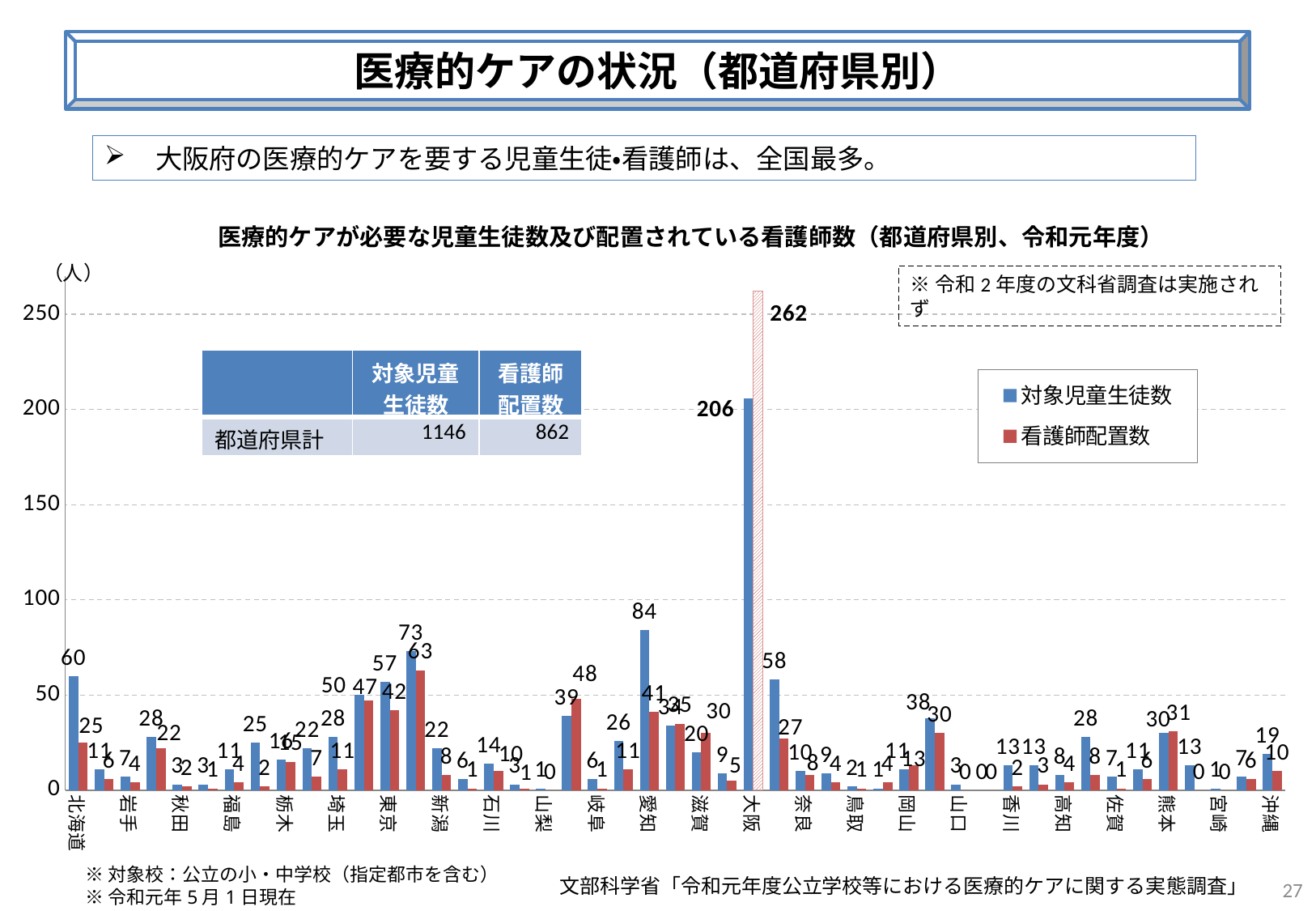
According to the table inside the chart, what is the 都道府県計 value for 対象児童生徒数? 1146 Which prefecture has the highest 対象児童生徒数? 大阪 Which has the larger 対象児童生徒数, 東京 or 愛知? 愛知 What is the difference between the 対象児童生徒数 and 看護師配置数 values for 北海道? 35 What is the 看護師配置数 value for 滋賀? 30 What is the 対象児童生徒数 value for 愛知? 84 What is the 看護師配置数 value for 沖縄? 10 How many series does the legend list? 2 What is the 対象児童生徒数 value for 北海道? 60 What is the 対象児童生徒数 value for 大阪? 206 What kind of chart is shown on the slide? bar chart What is the 看護師配置数 value for 東京? 42